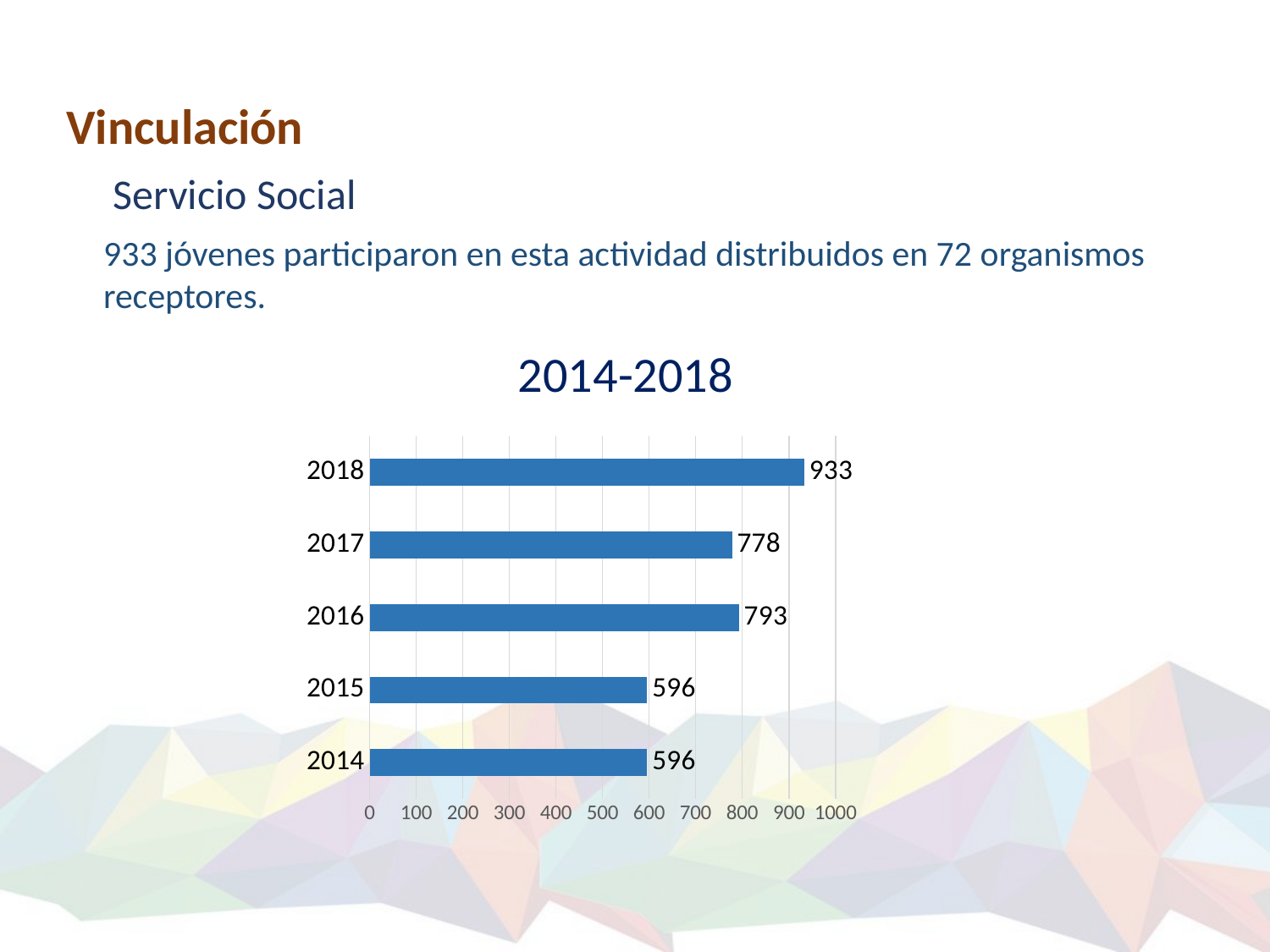
What is the difference between the values for 2016 and 2015? 197 Is the value for 2015 greater or less than 500? greater What is the value for 2016? 793 Which is larger, the value for 2016 or the value for 2017? 2016 What kind of chart is shown on the slide? Bar chart What is the title of the chart? 2014-2018 What is the value for 2018? 933 Which year has the highest value? 2018 What is the difference between the values for 2018 and 2017? 155 What is the value for 2014? 596 How many years are shown in the chart? 5 What is the value for 2017? 778